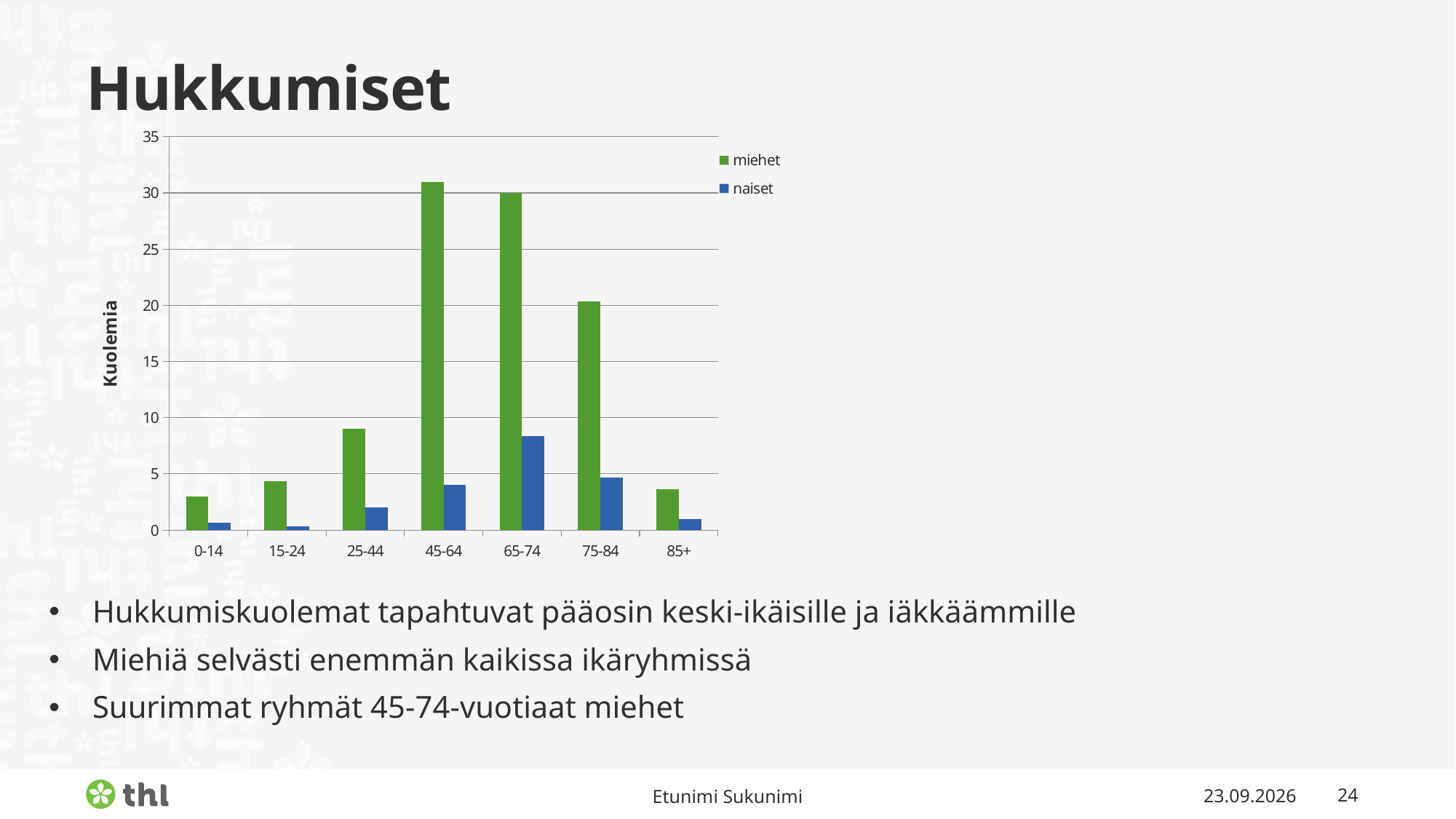
Is the value for naiset in the 65-74 age group greater or less than 5? greater Is the value for miehet in the 45-64 age group greater or less than 25? greater How many age groups are shown on the x axis of the chart? 7 Is the value for miehet in the 75-84 age group greater or less than 15? greater What kind of chart is shown on the slide? bar chart Which age group has the highest value for naiset? 65-74 How many series does the chart's legend list? 2 What is the title of the vertical axis of the chart? Kuolemia Which series does the chart's legend list first? miehet In the 65-74 age group, which series has the larger value, miehet or naiset? miehet For miehet, which age group has the larger value, 25-44 or 75-84? 75-84